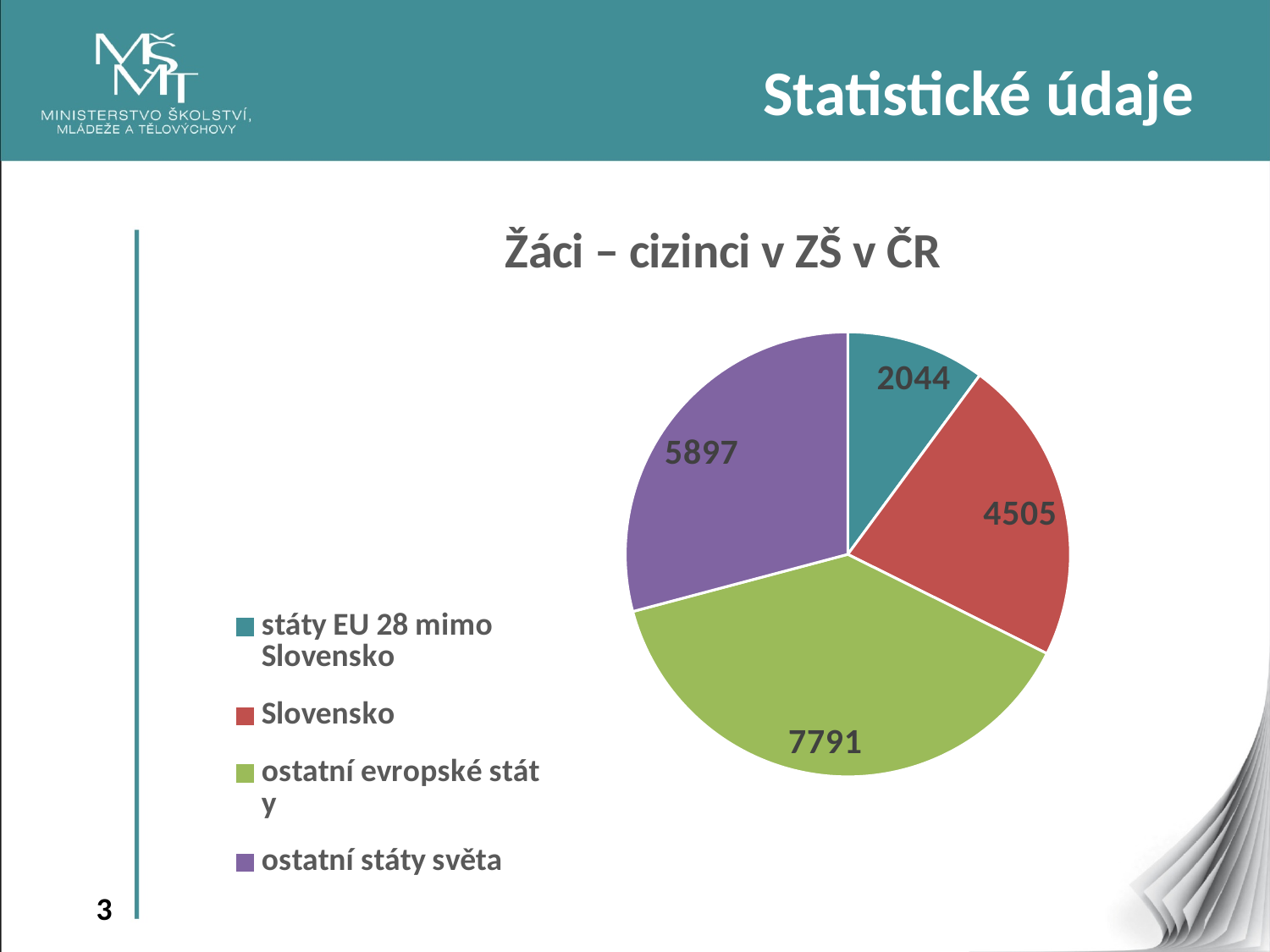
Which category has the smallest slice? státy EU 28 mimo Slovensko What is the value for státy EU 28 mimo Slovensko? 2044 What is the value for ostatní státy světa? 5897 Which is larger, the value for ostatní státy světa or the value for Slovensko? ostatní státy světa Which category has the largest slice? ostatní evropské státy What is the value for ostatní evropské státy? 7791 What is the difference between the values for ostatní evropské státy and Slovensko? 3286 What is the title of the chart? Žáci – cizinci v ZŠ v ČR How many categories does the pie chart have? 4 What is the total of all slices in the pie chart? 20237 What is the value for Slovensko? 4505 What kind of chart is shown on the slide? pie chart